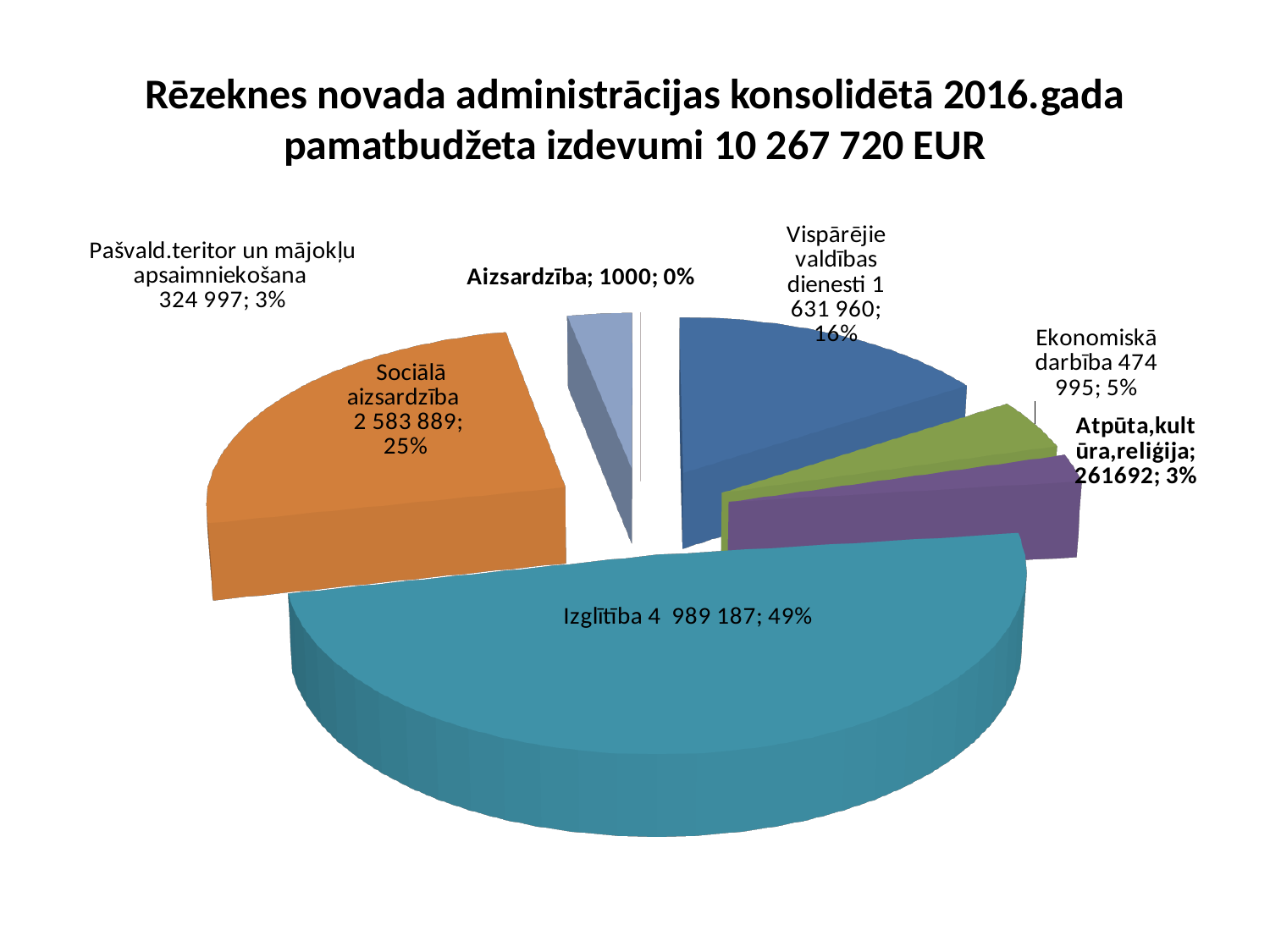
What share of the pie does Ekonomiskā darbība represent? 5% What is the value shown for Izglītība? 4 989 187 How many slices does the pie chart have? 7 What kind of chart is shown on the slide? pie chart Which category has the smallest slice of the pie? Aizsardzība What is the value shown for Aizsardzība? 1000 Which is larger, the value for Sociālā aizsardzība or the value for Vispārējie valdības dienesti? Sociālā aizsardzība What is the value shown for Vispārējie valdības dienesti? 1 631 960 What is the difference between the value for Ekonomiskā darbība and the value for Pašvald.teritor un mājokļu apsaimniekošana? 149 998 Which category has the largest slice of the pie? Izglītība What total amount in EUR is stated in the chart title? 10 267 720 EUR What share of the pie does Sociālā aizsardzība represent? 25%